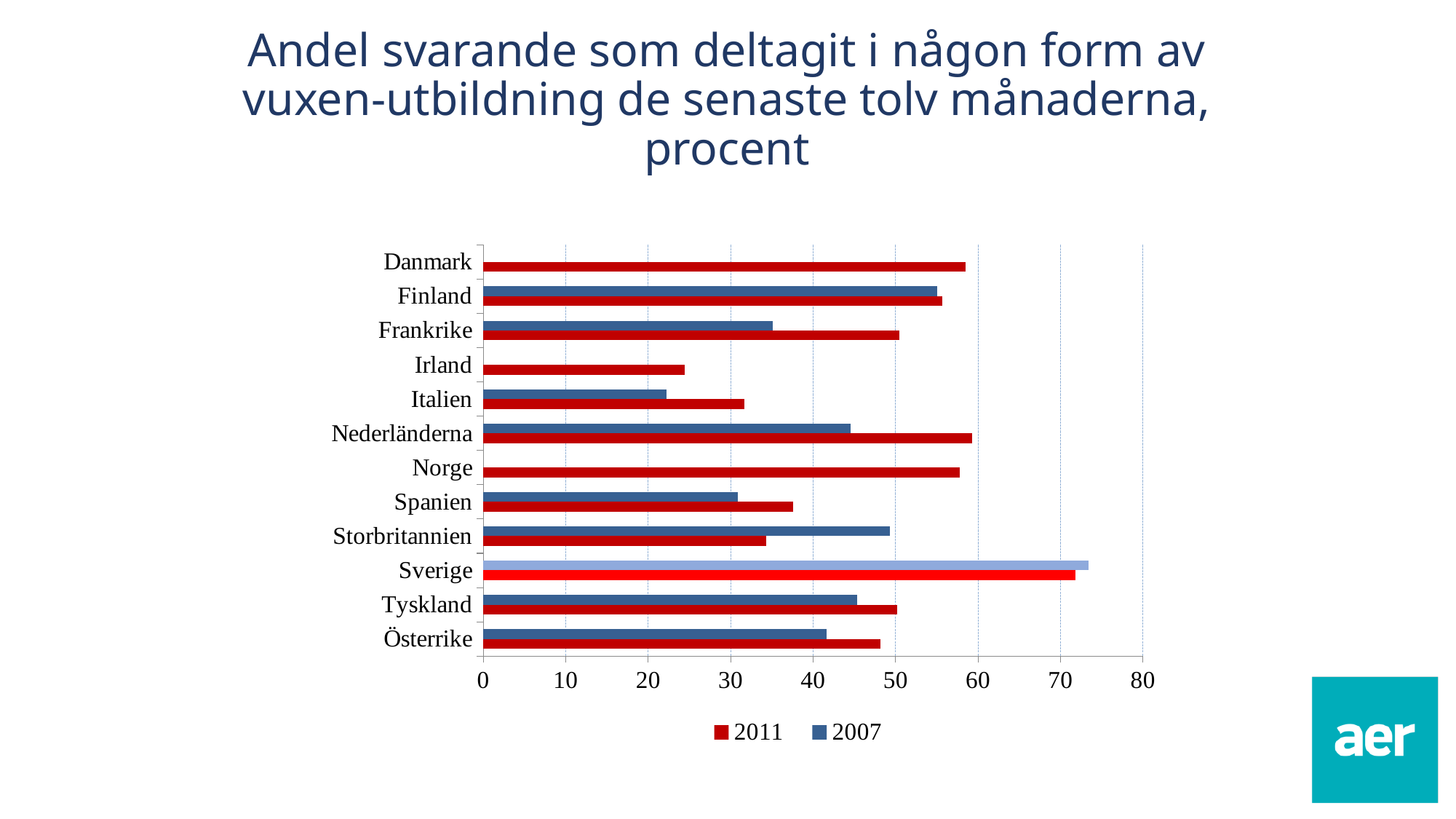
Which country has the lowest value for 2011? Irland Which country has the highest value for 2007? Sverige For Frankrike, which year has the larger value, 2011 or 2007? 2011 For Storbritannien, which year has the larger value, 2011 or 2007? 2007 Is the 2011 value for Nederländerna greater or less than 50? greater What kind of chart is shown on the slide? bar chart Is the 2011 value for Irland greater or less than 30? less How many series does the legend list? 2 Is the 2007 value for Sverige greater or less than 70? greater Which series is shown in red in the legend? 2011 Which country has the highest value for 2011? Sverige How many countries are listed on the vertical axis of the chart? 12